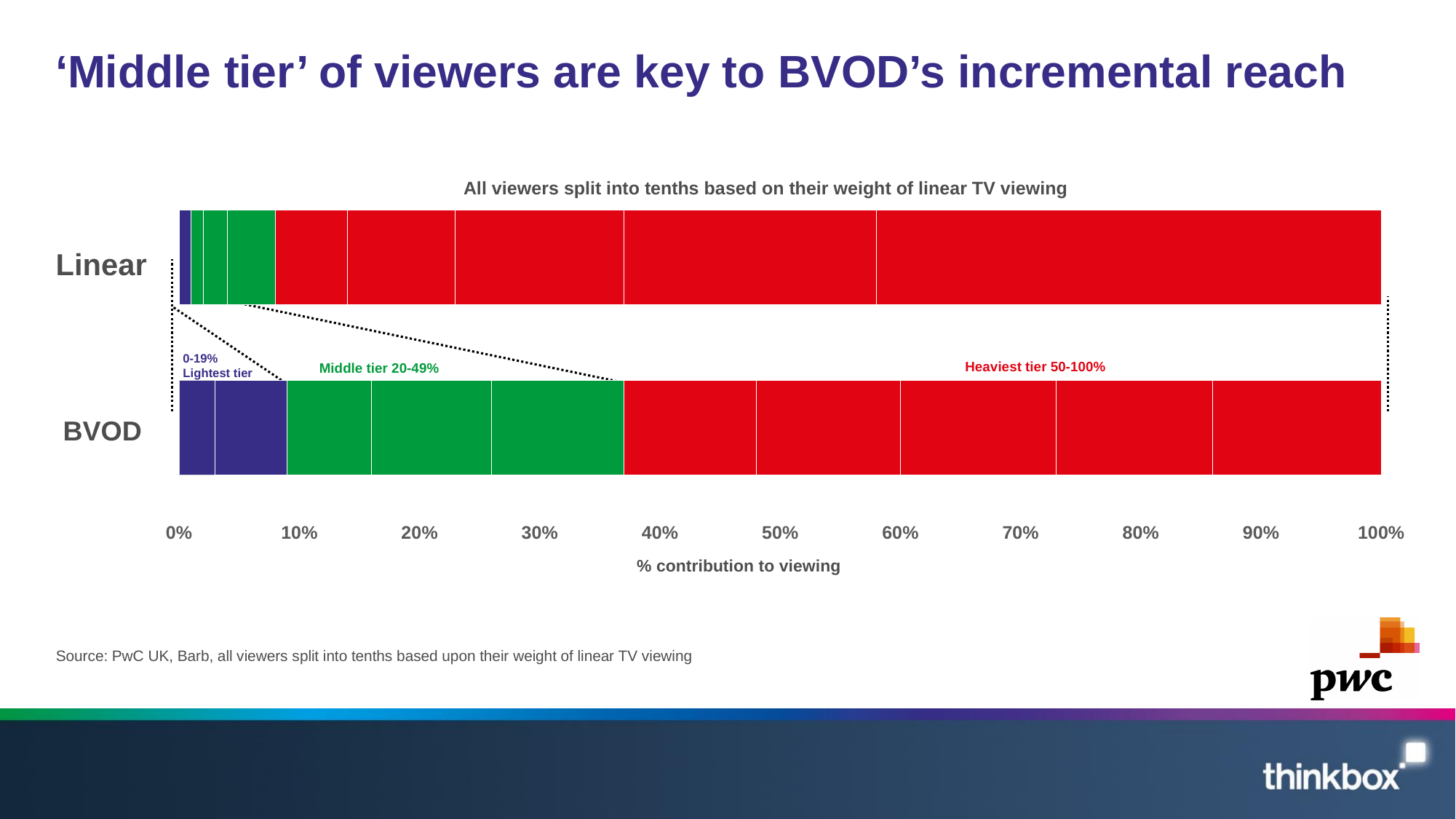
How many viewer tiers are labelled on the chart? 3 How many categories (bars) does the chart show? 2 Is the heaviest tier's contribution to BVOD viewing greater or less than 60%? greater What is the label of the x axis? % contribution to viewing Which bar has the larger share of viewing from the middle tier (20-49%), Linear or BVOD? BVOD Is the heaviest tier's contribution to Linear viewing greater or less than 90%? greater Into how many segments is each bar divided? 10 Is the middle tier's contribution to BVOD viewing greater or less than 20%? greater What kind of chart is shown on the slide? Stacked bar chart Which colour represents the heaviest tier (50-100%) of viewers? Red Which bar has the larger share of viewing from the heaviest tier (50-100%), Linear or BVOD? Linear